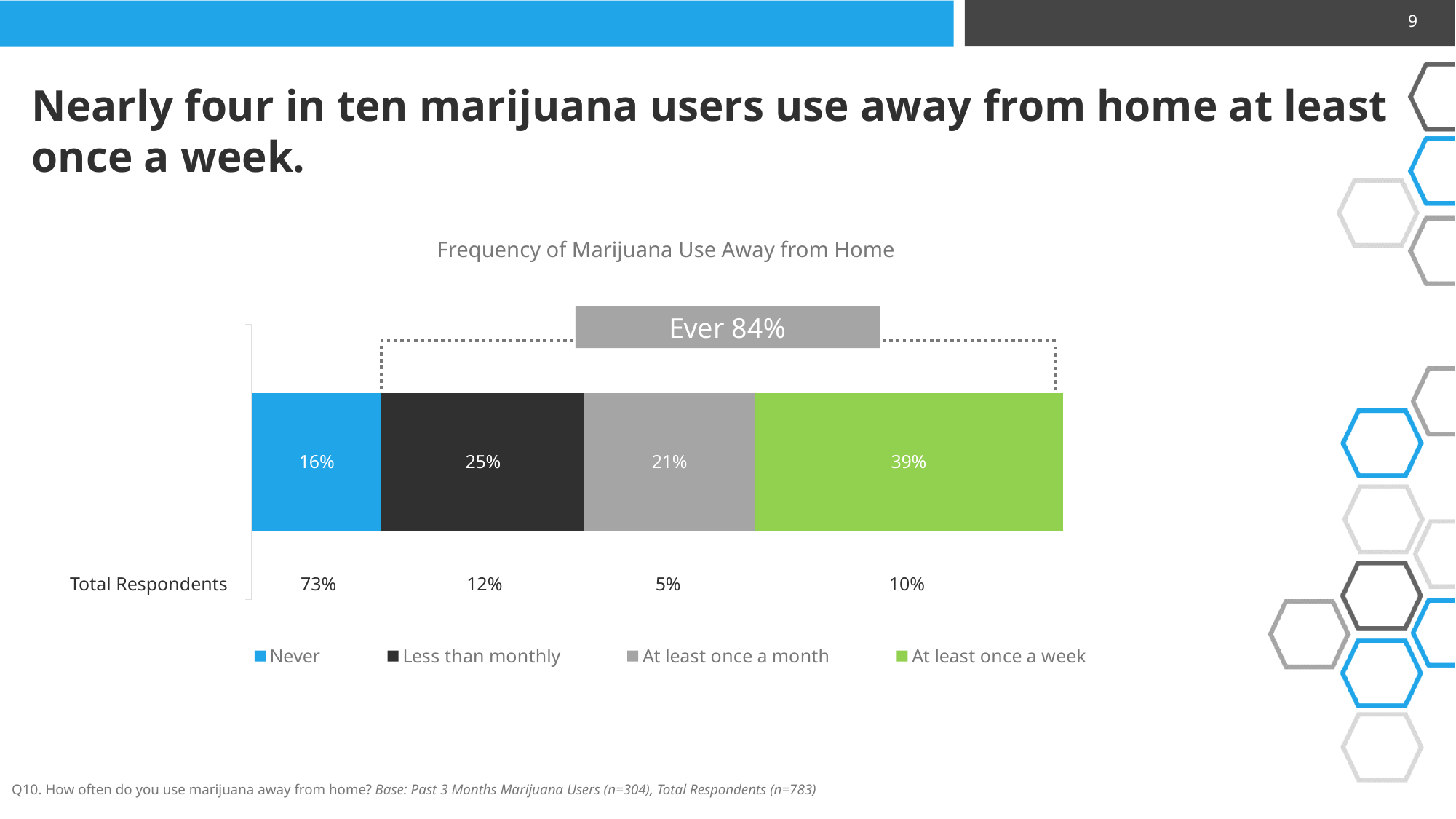
What percentage of marijuana users use away from home less than monthly, according to the stacked bar? 25% What is the difference between the 'At least once a week' and 'At least once a month' segments in the stacked bar? 18% What is the title of the chart? Frequency of Marijuana Use Away from Home How many entries does the chart legend list? 4 What kind of chart is shown on the slide? Stacked bar chart In the Total Respondents row, what percentage is shown for 'Never'? 73% Which frequency category has the largest segment in the stacked bar? At least once a week In the Total Respondents row, which is larger: 'Less than monthly' or 'At least once a week'? Less than monthly What percentage of marijuana users never use away from home, according to the stacked bar? 16% What percentage of marijuana users use away from home at least once a week, according to the stacked bar? 39% What percentage is shown for 'Ever' above the stacked bar? 84% Which frequency category has the smallest segment in the stacked bar? Never